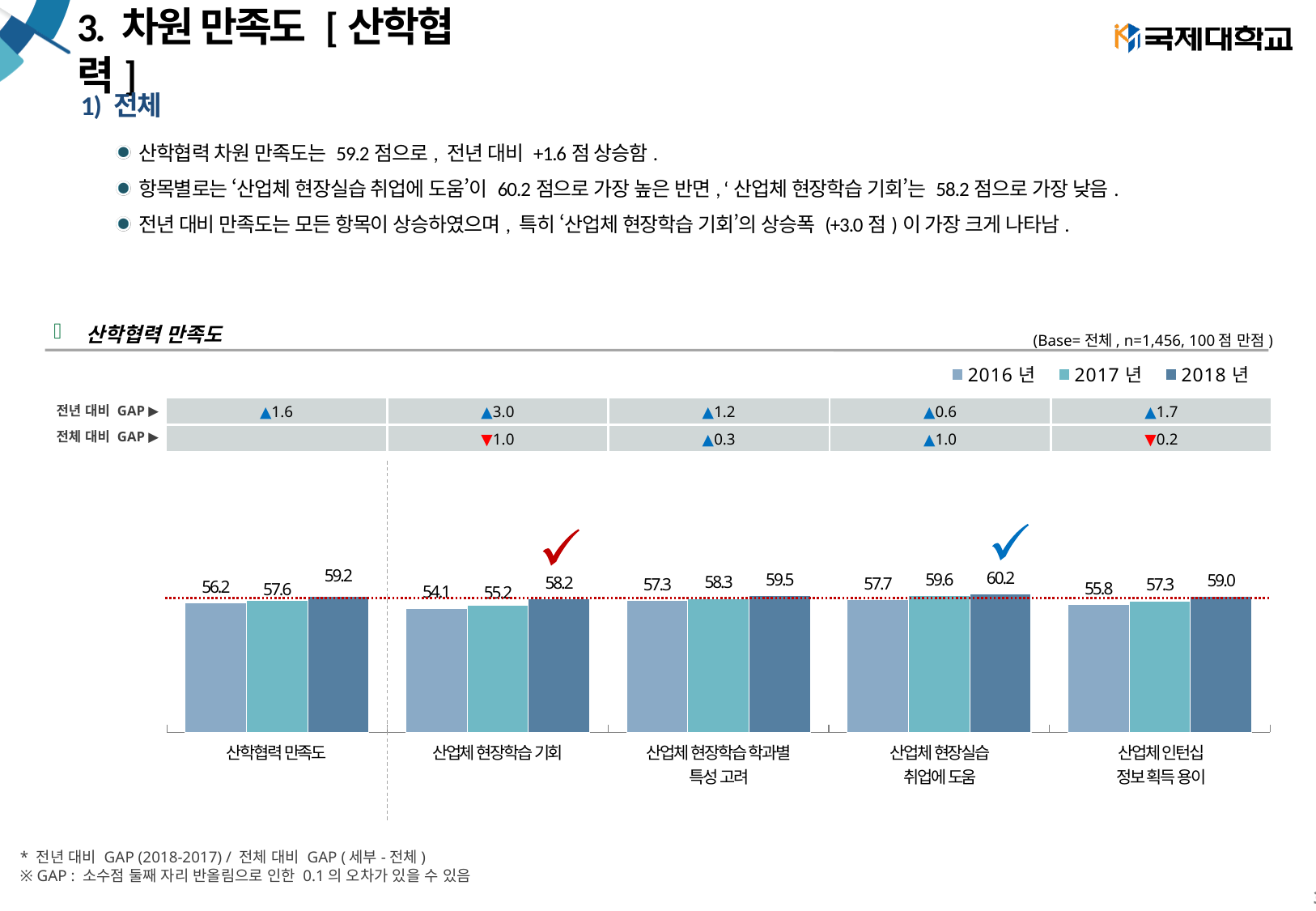
What is the 2017년 value for 산업체 인턴십 정보 획득 용이? 57.3 Which is larger: the 2018년 value for 산학협력 만족도 or the 2018년 value for 산업체 현장학습 학과별 특성 고려? 산업체 현장학습 학과별 특성 고려 Which category has the lowest 2016년 value? 산업체 현장학습 기회 What is the title of the chart? 산학협력 만족도 Which category has the highest 2018년 value? 산업체 현장실습 취업에 도움 For 산업체 인턴십 정보 획득 용이, do the values rise or fall from 2016년 to 2018년? rise What is the difference between the 2018년 and 2017년 values for 산업체 현장학습 기회? 3.0 What is the 2016년 value for 산업체 현장학습 기회? 54.1 What is the 2018년 value for 산업체 현장실습 취업에 도움? 60.2 How many series does the legend list? 3 How many categories are shown on the x axis of the chart? 5 What kind of chart is shown on the slide? bar chart